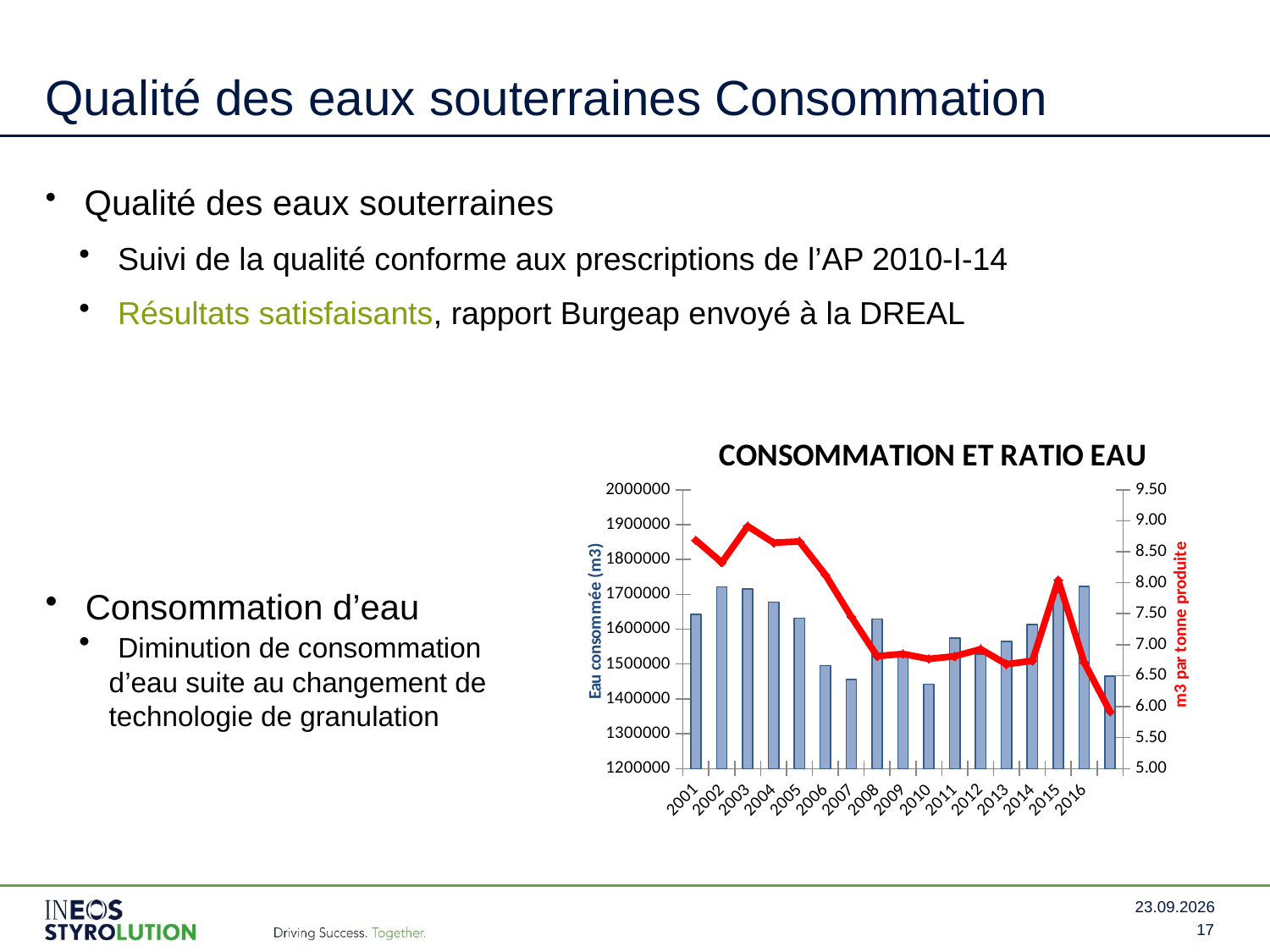
Which bar is taller, 2002 or 2007? 2002 Is the line (ratio) value for 2003 greater or less than 8.50? greater Which year has the highest line (ratio) value? 2003 Is the bar value for 2002 greater or less than 1700000? greater Do the bar values rise or fall from 2005 to 2007? fall Is the bar value for 2010 greater or less than 1500000? less What is the title of the chart? CONSOMMATION ET RATIO EAU What is the label of the right-hand vertical axis of the chart? m3 par tonne produite What kind of chart is shown on the slide? A combined bar and line chart